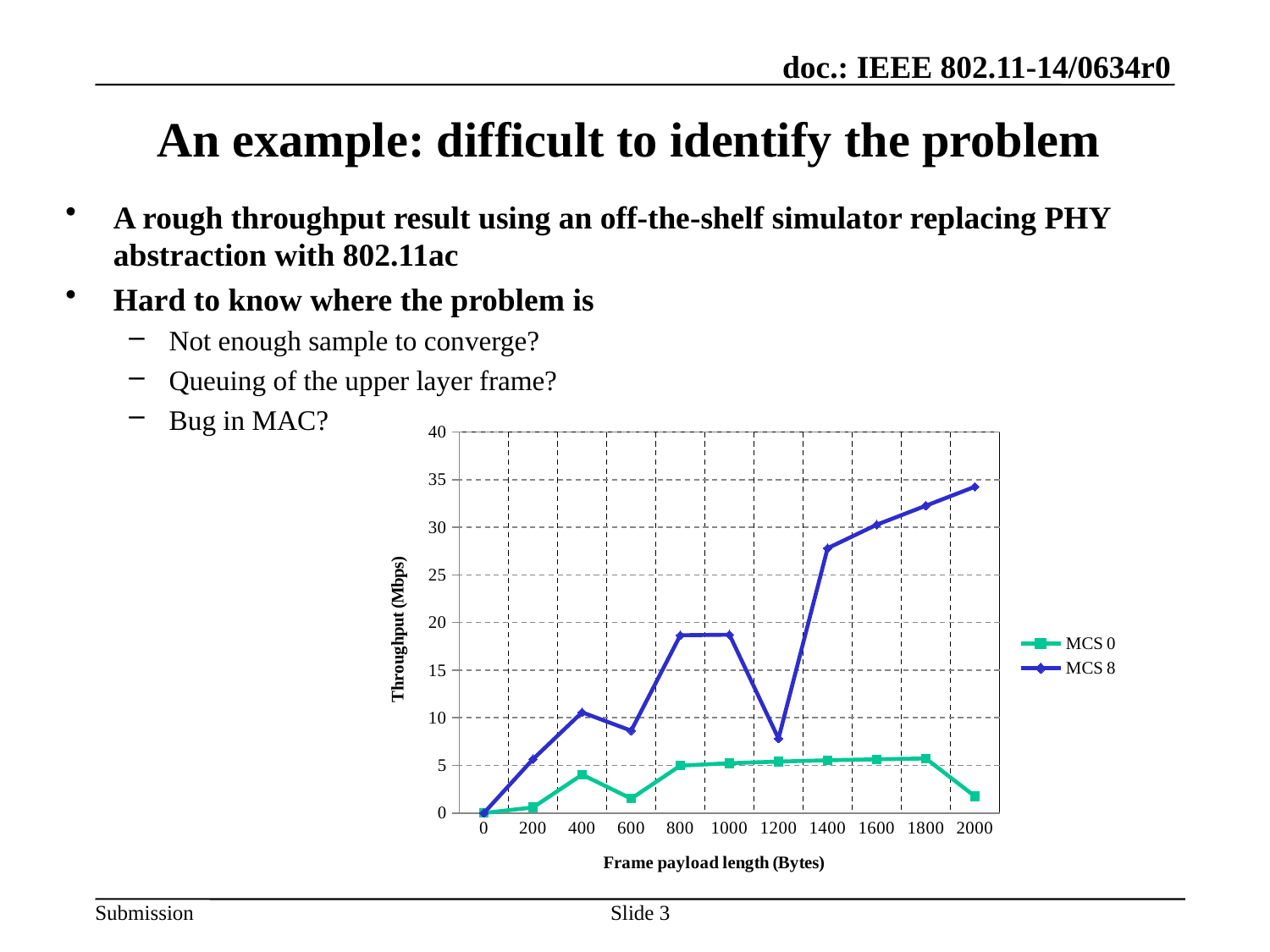
At which frame payload length is the MCS 8 throughput lowest? 0 What is the label of the vertical axis? Throughput (Mbps) At a frame payload length of 1400 bytes, which series has the higher throughput, MCS 0 or MCS 8? MCS 8 How many series does the legend list? 2 What kind of chart is shown on the slide? line chart How many frame payload length points are plotted for each series? 11 Is the MCS 0 throughput at a frame payload length of 1800 bytes greater or less than 10 Mbps? less Is the MCS 8 throughput at a frame payload length of 2000 bytes greater or less than 30 Mbps? greater At which frame payload length is the MCS 8 throughput highest? 2000 What is the label of the horizontal axis? Frame payload length (Bytes) Is the MCS 8 throughput at a frame payload length of 1200 bytes greater or less than 10 Mbps? less